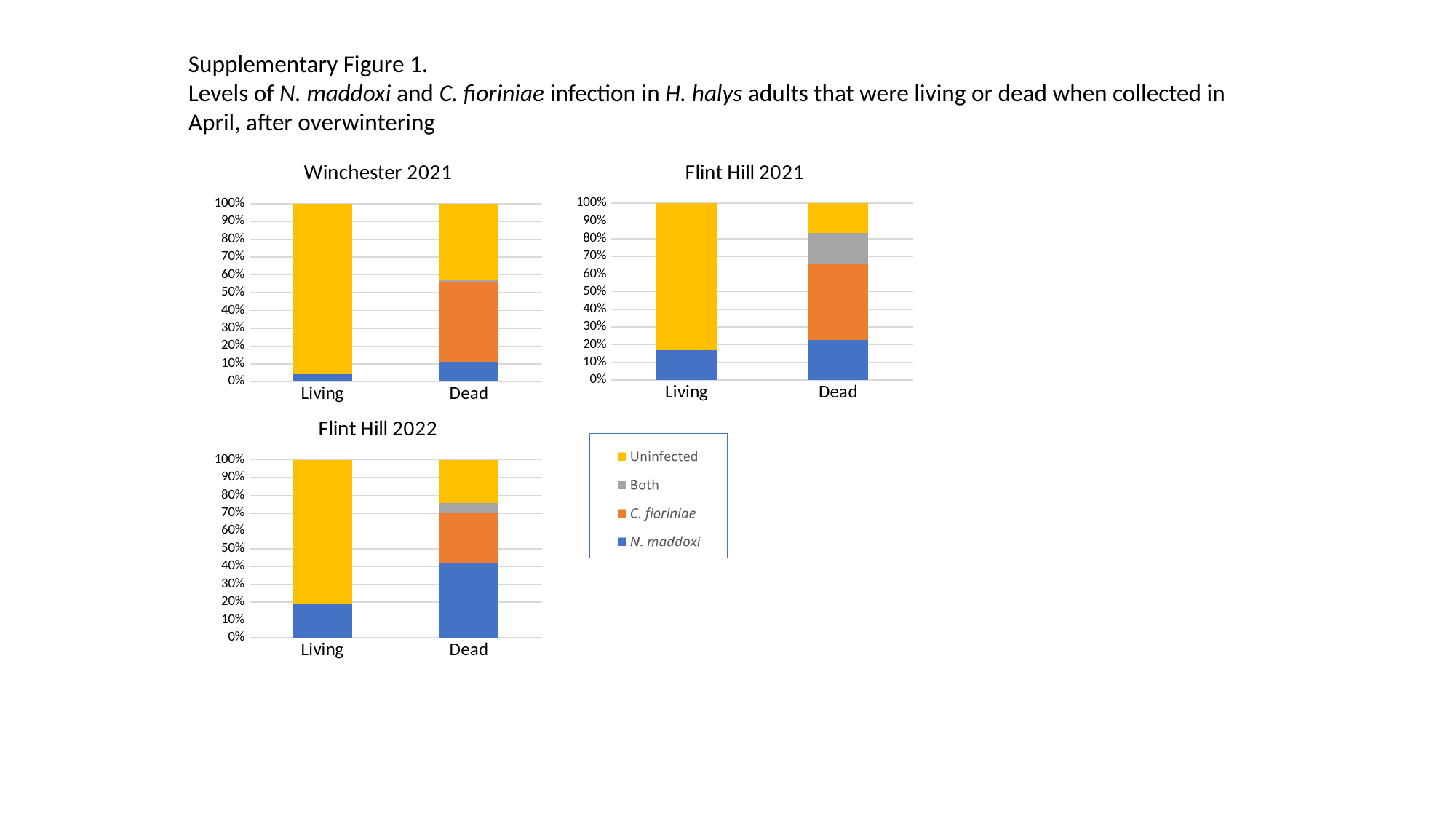
In the Winchester 2021 chart, is the Uninfected value larger for Living or for Dead? Living How many series does the legend list for the charts? 4 What is the title of the chart in the bottom-left of the slide? Flint Hill 2022 In the Flint Hill 2021 chart, what is the total of the stacked bar for Dead? 100% In the Flint Hill 2022 chart, is the N. maddoxi value for Dead greater or less than 30%? greater How many categories are shown on the x axis of the Winchester 2021 chart? 2 What kind of chart is the Winchester 2021 chart? stacked bar chart In the Flint Hill 2021 chart, is the Uninfected value for Dead greater or less than 30%? less In the Winchester 2021 chart, is the N. maddoxi value for Living greater or less than 10%? less What colour represents Uninfected in the legend? yellow In the Flint Hill 2022 chart, is the N. maddoxi value larger for Living or for Dead? Dead